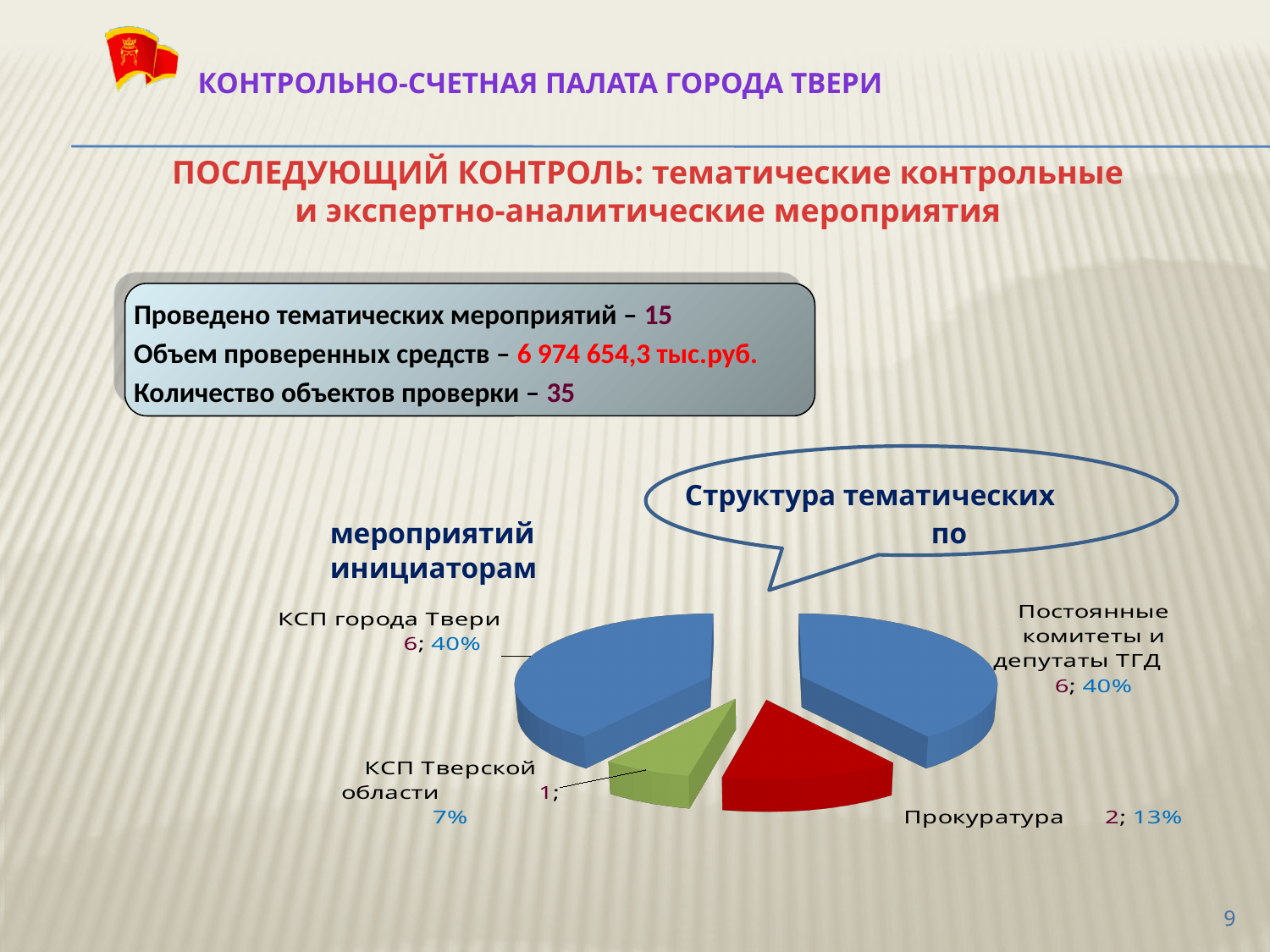
What kind of chart is shown on the slide? pie chart What colour is the slice for "Прокуратура"? red What value is shown for the slice "КСП Тверской области"? 1; 7% What is the difference in count between "Прокуратура" and "КСП Тверской области"? 1 What value is shown for the slice "Прокуратура"? 2; 13% What is the difference in count between "КСП города Твери" and "Прокуратура"? 4 Which is larger: the slice for "Прокуратура" or the slice for "КСП Тверской области"? Прокуратура What value is shown for the slice "КСП города Твери"? 6; 40% How many slices does the pie chart have? 4 Which slice of the pie chart is the smallest? КСП Тверской области What is the total count across all slices of the pie chart? 15 What share of the pie does "Постоянные комитеты и депутаты ТГД" account for? 40%